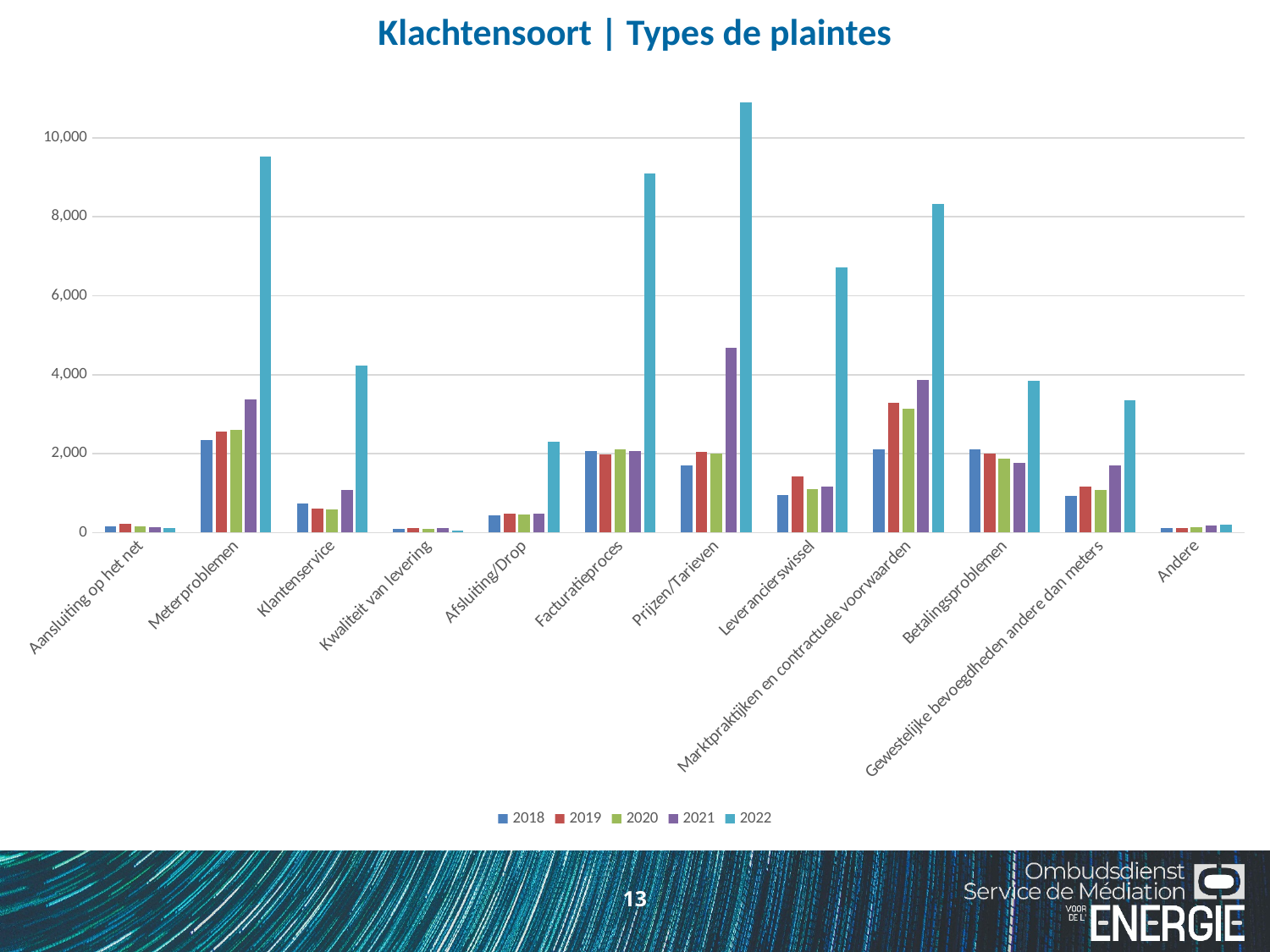
Which category has the highest 2021 value? Prijzen/Tarieven Is the 2019 value for Marktpraktijken en contractuele voorwaarden greater or less than 2,000? greater Is the 2022 value for Leverancierswissel greater or less than 6,000? greater What kind of chart is shown on the slide? bar chart Which category has the lowest 2022 value? Kwaliteit van levering Which is larger: the 2021 value for Prijzen/Tarieven or the 2021 value for Meterproblemen? Prijzen/Tarieven Which year does the legend list first? 2018 Is the 2022 value for Meterproblemen greater or less than 8,000? greater How many series does the legend list? 5 How many complaint categories are shown on the x axis? 12 Which category has the highest 2022 value? Prijzen/Tarieven What is the title of the chart? Klachtensoort | Types de plaintes